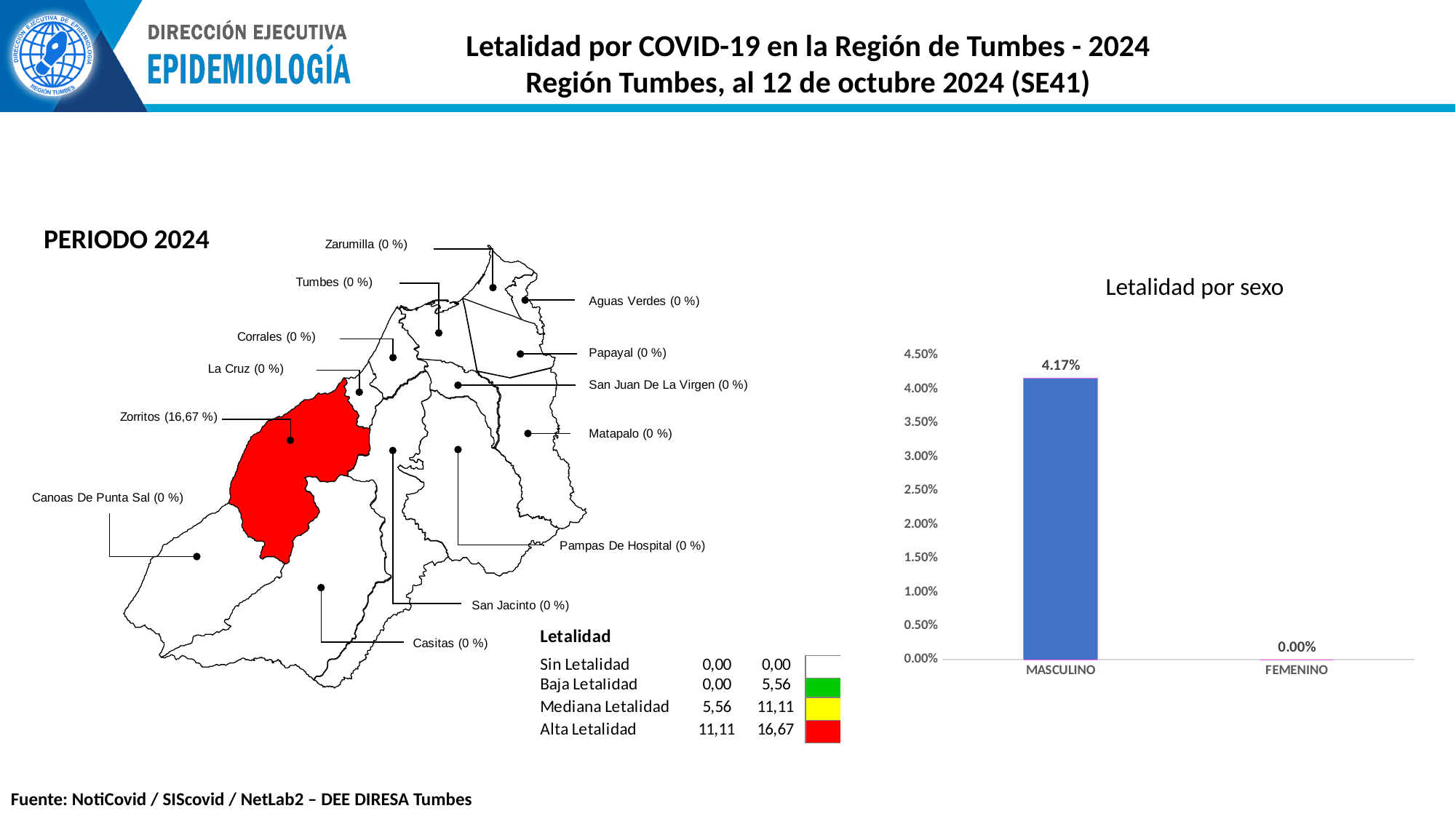
On the map 'PERIODO 2024', what is the lethality value shown for Zorritos? 16,67 % In the 'Letalidad por sexo' chart, what is the difference between the MASCULINO and FEMENINO values? 4.17% On the map 'PERIODO 2024', what is the lethality value shown for Tumbes? 0 % In the 'Letalidad por sexo' chart, which category has the highest value? MASCULINO In the 'Letalidad por sexo' chart, which category has the lowest value? FEMENINO In the 'Letalidad por sexo' chart, what is the value for FEMENINO? 0.00% What kind of chart is 'Letalidad por sexo'? bar chart In the 'Letalidad por sexo' chart, how many categories are shown on the x axis? 2 On the map 'PERIODO 2024', which district is shaded red? Zorritos In the 'Letalidad por sexo' chart, is the value for MASCULINO greater or less than 4.00%? greater In the 'Letalidad por sexo' chart, what is the value for MASCULINO? 4.17% In the 'Letalidad por sexo' chart, what is the highest value shown on the y axis? 4.50%